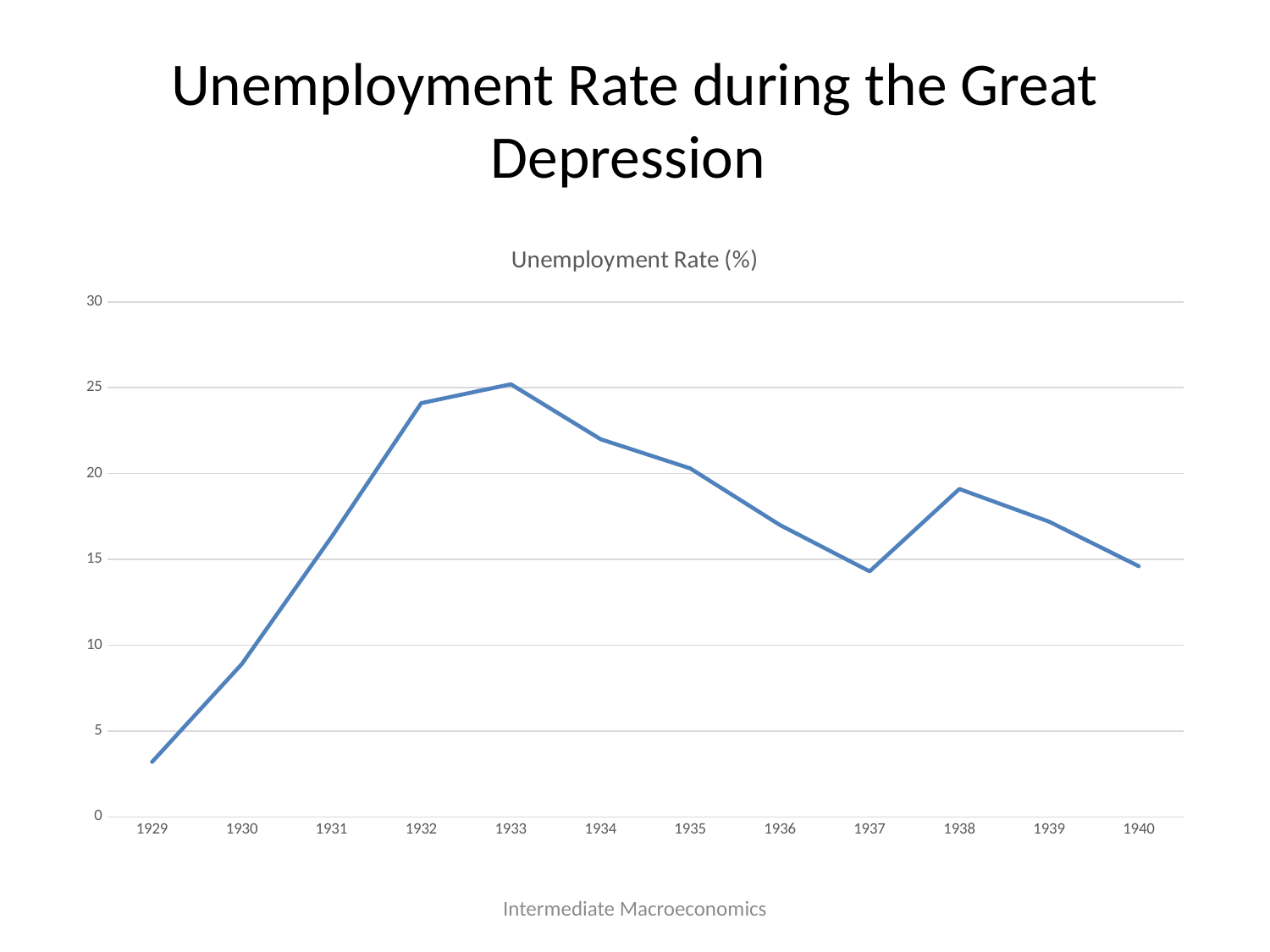
Is the unemployment rate for 1929 greater or less than 5? less How many years are plotted on the x axis? 12 Is the unemployment rate for 1932 greater or less than 20? greater Which year has the higher unemployment rate, 1932 or 1934? 1932 Is the unemployment rate for 1937 greater or less than 15? less What kind of chart is shown on the slide? line chart Does the unemployment rate rise or fall from 1933 to 1937? fall In which year is the unemployment rate lowest? 1929 What is the title shown above the chart? Unemployment Rate (%) In which year is the unemployment rate highest? 1933 Does the unemployment rate rise or fall from 1929 to 1933? rise